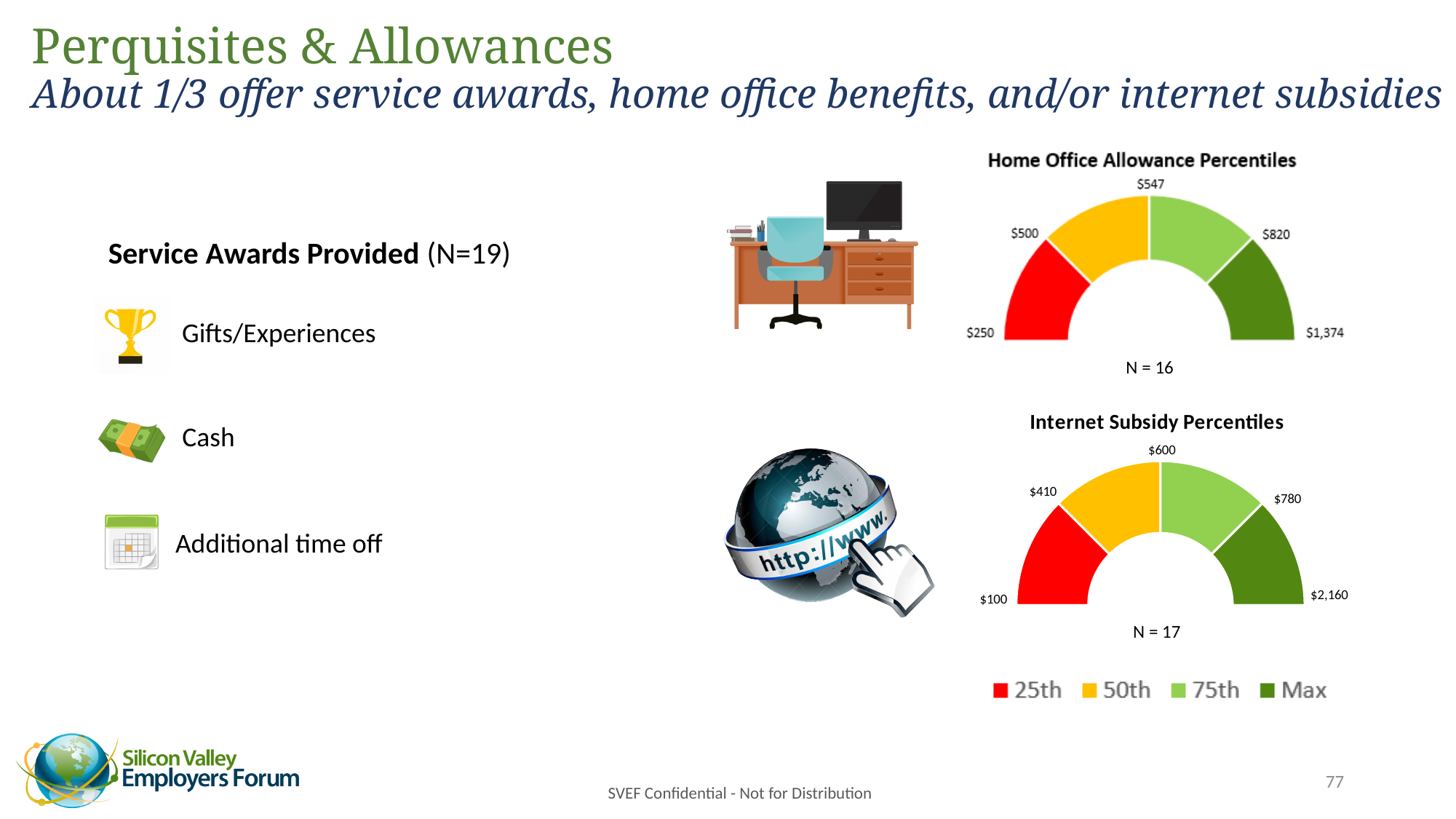
How many entries does the legend below the Internet Subsidy Percentiles chart list? 4 Which is larger: the maximum value in the Internet Subsidy Percentiles chart or the maximum value in the Home Office Allowance Percentiles chart? Internet Subsidy Percentiles ($2,160) What kind of chart is used for the Home Office Allowance Percentiles? Gauge chart What is the difference between the 75th percentile value ($820) and the 25th percentile value ($500) in the Home Office Allowance Percentiles chart? $320 What is the difference between the 50th percentile values of the Internet Subsidy Percentiles chart ($600) and the Home Office Allowance Percentiles chart ($547)? $53 In the Home Office Allowance Percentiles chart, what is the lowest value shown on the gauge? $250 In the Internet Subsidy Percentiles chart, what is the 50th percentile value shown at the top of the gauge? $600 In the Internet Subsidy Percentiles chart, what is the 75th percentile value? $780 In the Internet Subsidy Percentiles chart, what is the maximum value shown? $2,160 In the Home Office Allowance Percentiles chart, what is the 50th percentile value shown at the top of the gauge? $547 What is the sample size (N) shown under the Internet Subsidy Percentiles chart? N = 17 In the Home Office Allowance Percentiles chart, what is the maximum value shown? $1,374